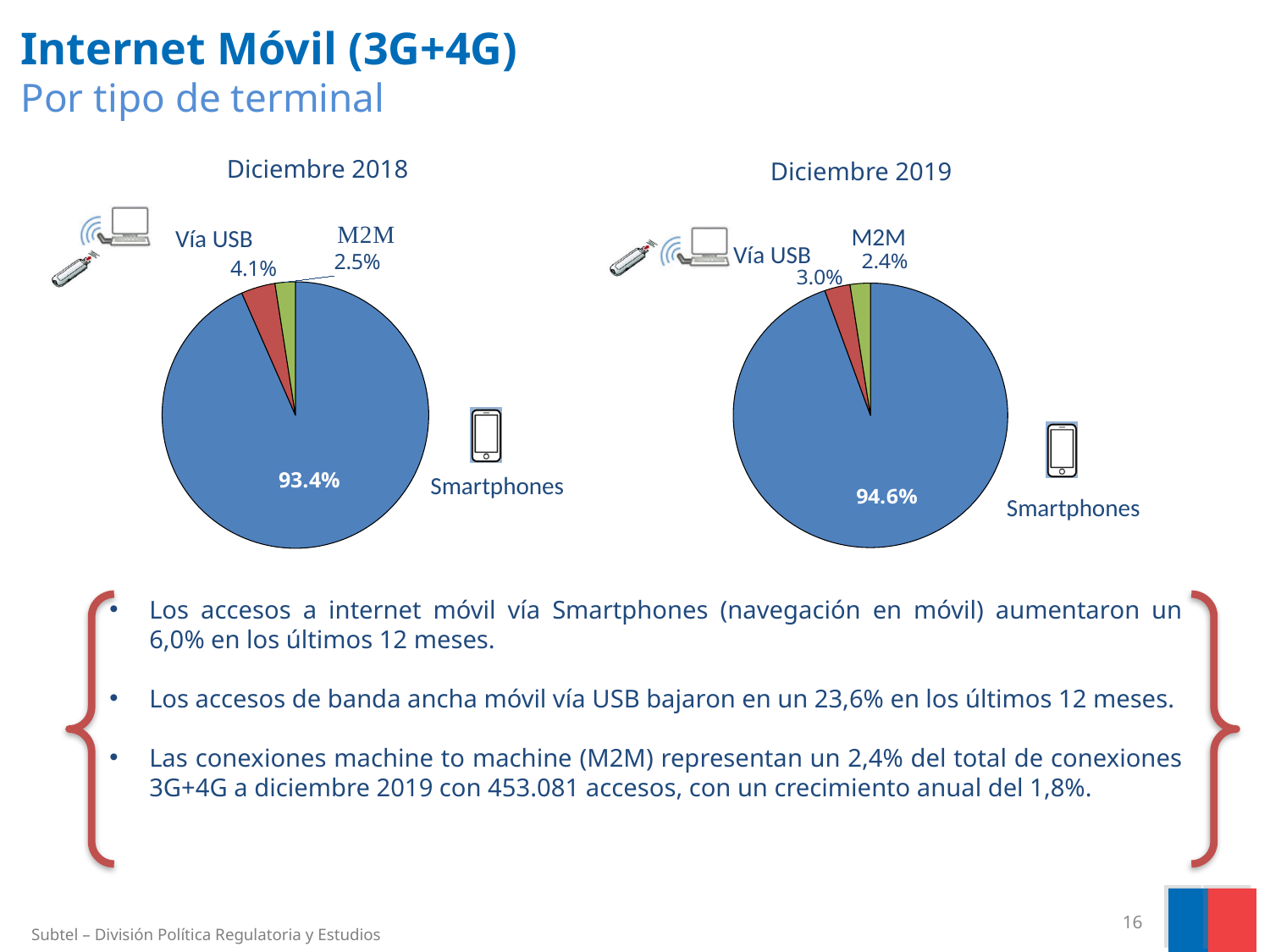
What type of chart is used for Diciembre 2018? Pie chart How many categories does the Diciembre 2019 pie chart show? 3 In the Diciembre 2018 pie chart, what is the difference between the Vía USB and M2M shares? 1.6% In the Diciembre 2019 pie chart, which is larger, Vía USB or M2M? Vía USB In the Diciembre 2019 pie chart, what is the value for M2M? 2.4% What is the difference between the Vía USB share in Diciembre 2018 and in Diciembre 2019? 1.1% In the Diciembre 2018 pie chart, which category has the smallest slice? M2M In the Diciembre 2019 pie chart, which category has the largest slice? Smartphones In the Diciembre 2019 pie chart, what colour is the Smartphones slice? Blue In the Diciembre 2018 pie chart, what share do Smartphones have? 93.4% In the Diciembre 2018 pie chart, what is the value for Vía USB? 4.1% In the Diciembre 2019 pie chart, what share do Smartphones have? 94.6%